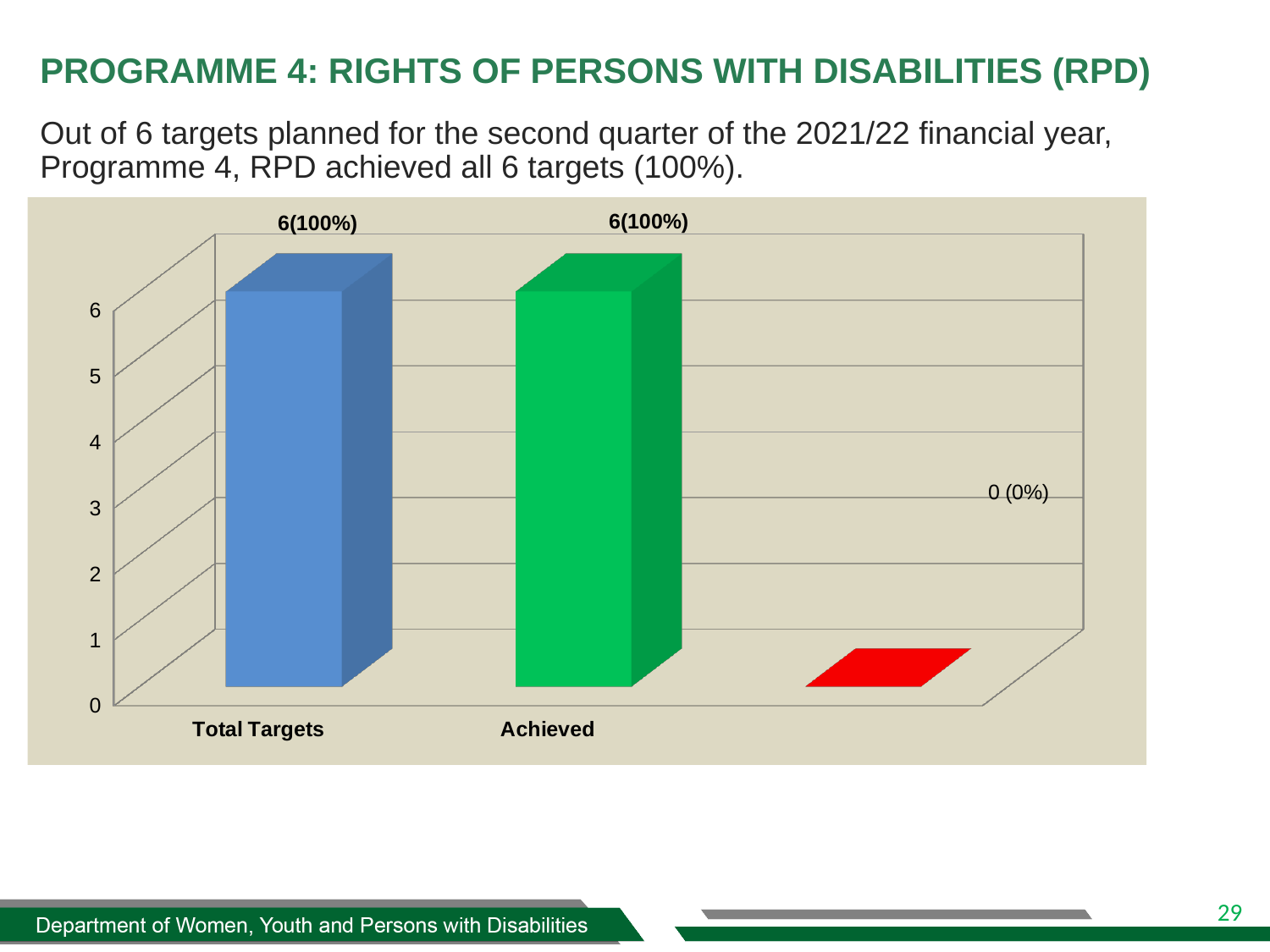
What is the highest value shown on the vertical axis? 6 Is the Achieved bar larger than, smaller than, or equal to the Total Targets bar? equal What is the difference between the Total Targets value and the Achieved value? 0 How many bars are plotted in the chart? 3 What colour is the Achieved bar? green What value is labelled on the red bar at the right of the chart? 0 (0%) Is the value for Achieved greater or less than 3? greater What value is shown for Total Targets? 6(100%) Which bar has the lowest value? the red bar (0 (0%)) What value is shown for Achieved? 6(100%) What kind of chart is shown on the slide? bar chart Is the value of the red bar greater or less than 1? less